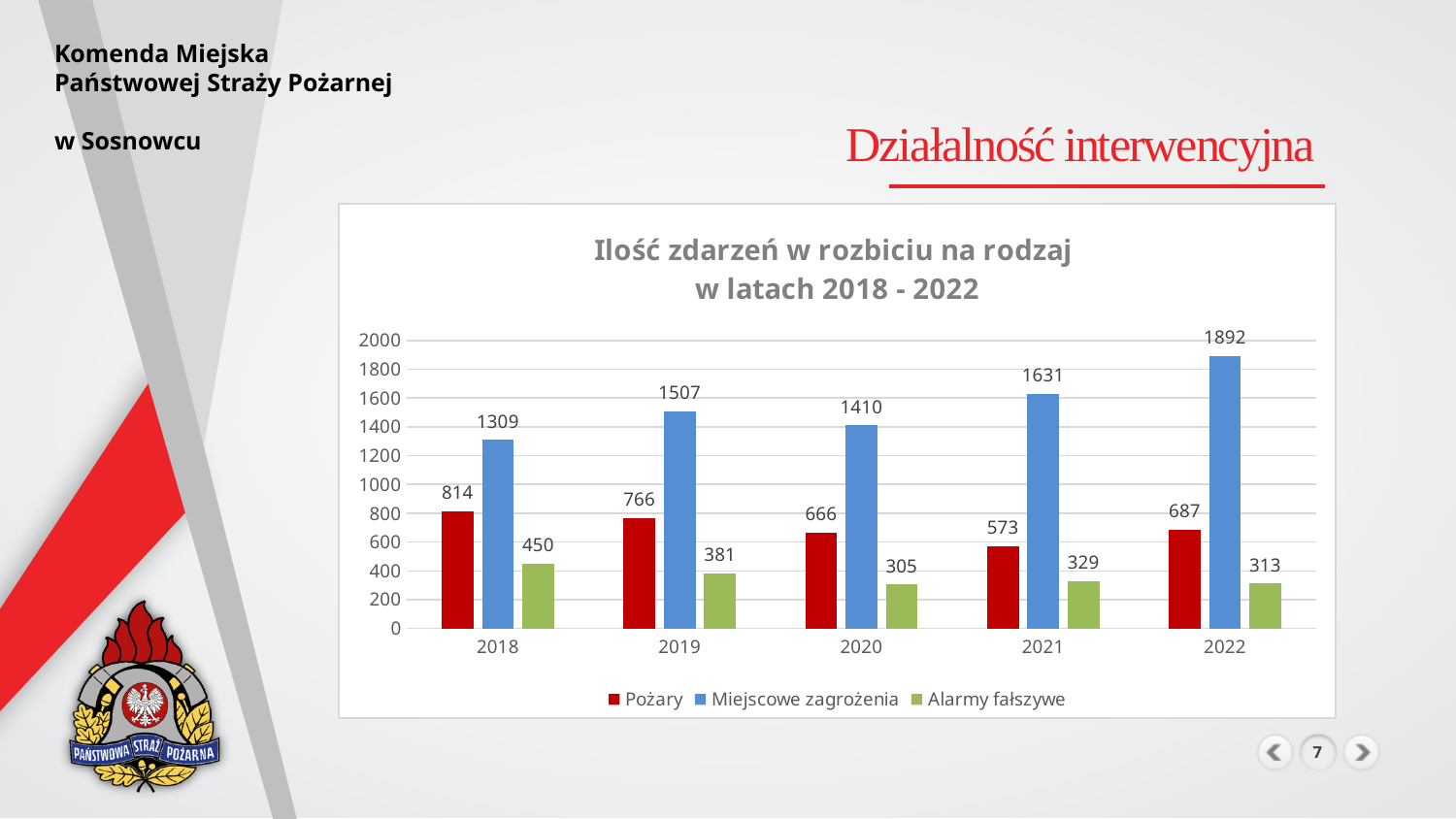
Is the value for Miejscowe zagrożenia in 2019 greater or less than 1400? greater What is the difference between Miejscowe zagrożenia in 2022 and in 2021? 261 How many series does the legend list? 3 What is the value for Miejscowe zagrożenia in 2022? 1892 In which year is the value for Pożary lowest? 2021 Does the value for Miejscowe zagrożenia rise or fall from 2020 to 2022? rise In which year is the value for Miejscowe zagrożenia highest? 2022 What is the value for Pożary in 2018? 814 What is the value for Alarmy fałszywe in 2020? 305 How many years are shown on the x axis? 5 What kind of chart is shown on the slide? bar chart Which is larger: Pożary in 2019 or Pożary in 2022? Pożary in 2019